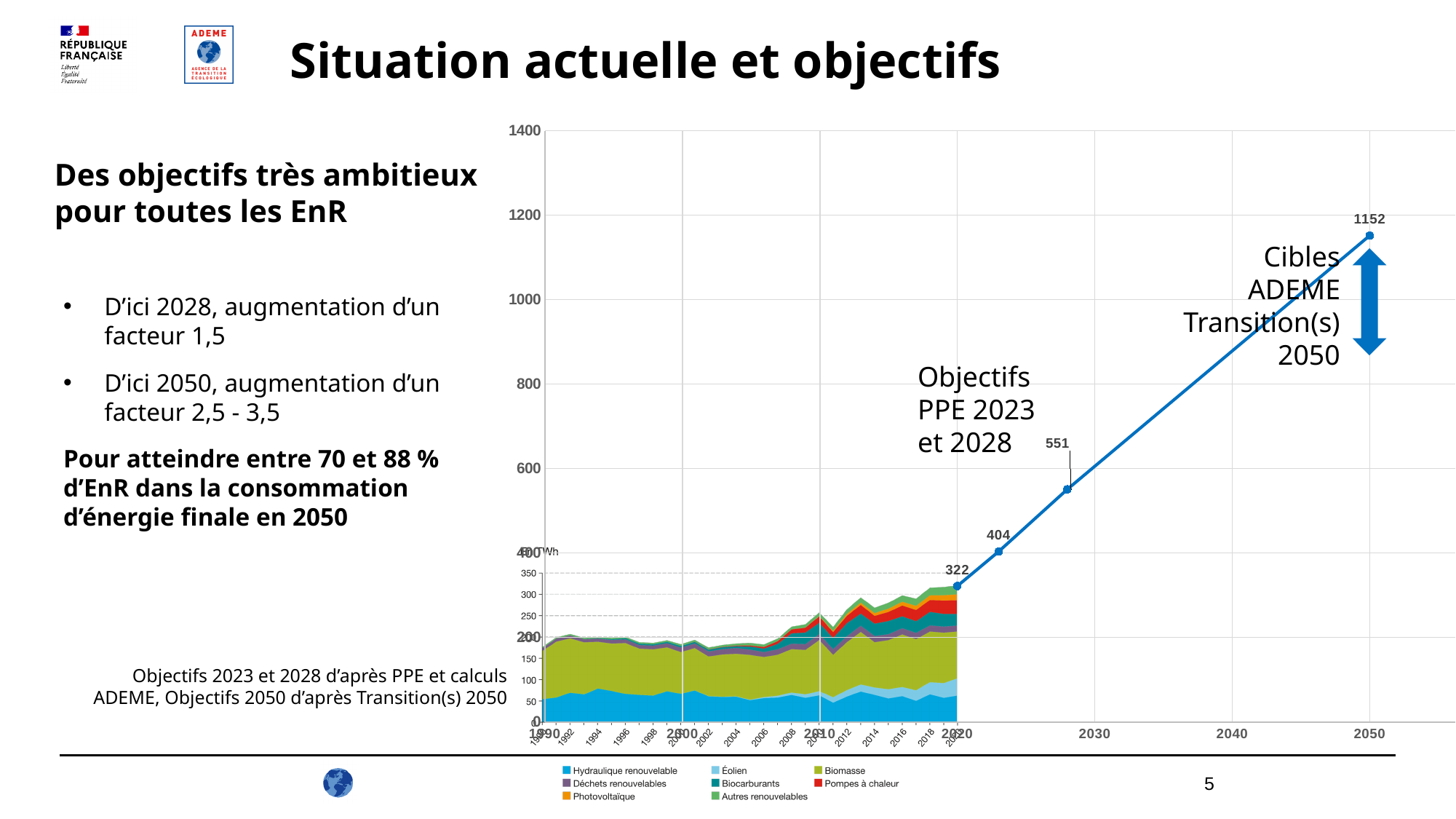
On the line chart, do the values rise or fall from 2020 to 2050? rise On the line chart, which labelled year has the highest value? 2050 On the line chart, what value is labelled for the year 2020? 322 On the line chart, what is the difference between the 2050 value and the 2028 value? 601 On the line chart, what value is labelled for the year 2023? 404 On the line chart, what value is labelled for the year 2050? 1152 On the line chart, what value is labelled for the year 2028? 551 On the line chart, which labelled year has the lowest value? 2020 On the line chart, what is the difference between the 2028 value and the 2023 value? 147 How many series does the legend of the stacked area chart list? 8 What kind of chart shows the objectives from 2020 to 2050? line chart How many labelled data points are on the line chart? 4